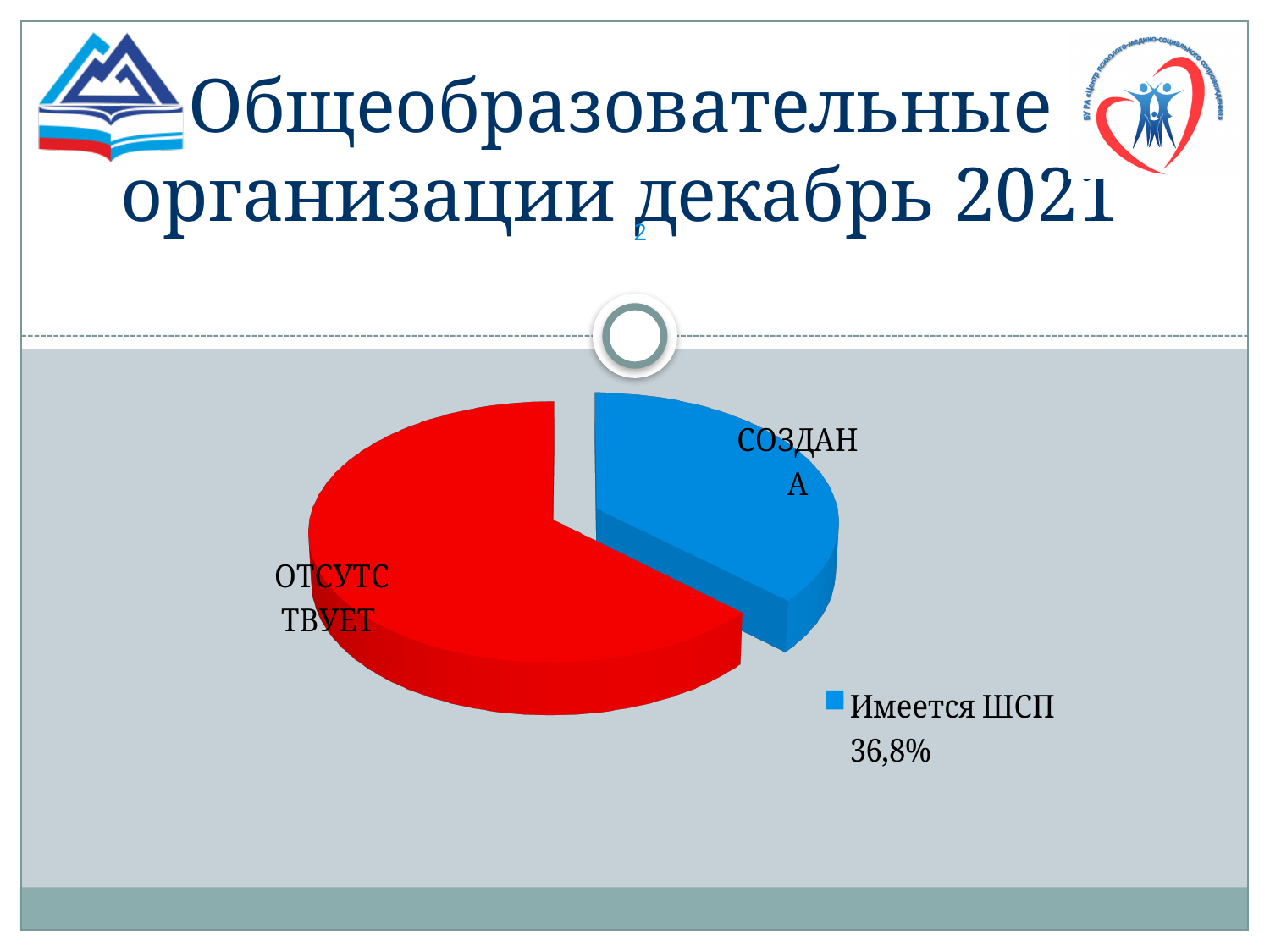
Which slice of the pie chart is the smallest? СОЗДАНА How many slices does the pie chart have? 2 What kind of chart is shown on the slide? pie chart How many entries does the chart legend list? 1 What colour is the СОЗДАНА slice of the pie chart? blue What is the text of the legend entry on the chart? Имеется ШСП 36,8% Which slice is larger, ОТСУТСТВУЕТ or СОЗДАНА? ОТСУТСТВУЕТ Is the share of the ОТСУТСТВУЕТ slice greater or less than 50%? greater What percentage is shown in the legend for Имеется ШСП? 36,8% Which slice of the pie chart is the largest? ОТСУТСТВУЕТ Is the share of the СОЗДАНА slice greater or less than 50%? less